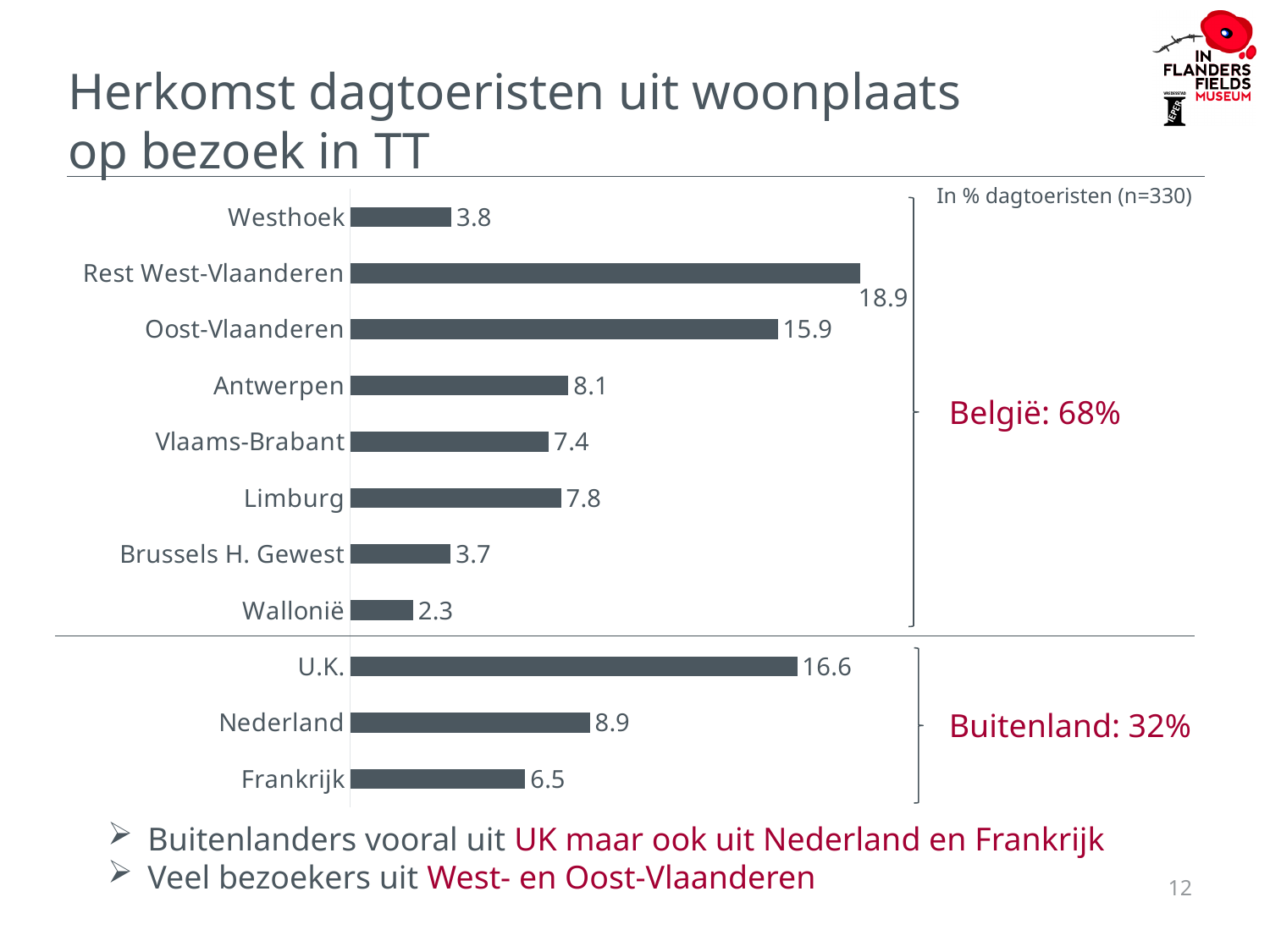
Which is larger, the value for Limburg or the value for Vlaams-Brabant? Limburg What kind of chart is shown on the slide? bar chart What percentage share is given for België on the slide? 68% What is the difference between the values for Oost-Vlaanderen and Antwerpen? 7.8 Which is larger, the value for Nederland or the value for Frankrijk? Nederland Which category has the highest value? Rest West-Vlaanderen Which category has the lowest value? Wallonië What is the value for Wallonië? 2.3 What is the value for Rest West-Vlaanderen? 18.9 What sample size (n) is stated in the chart's note? n=330 How many categories are shown in the chart? 11 What is the value for U.K.? 16.6